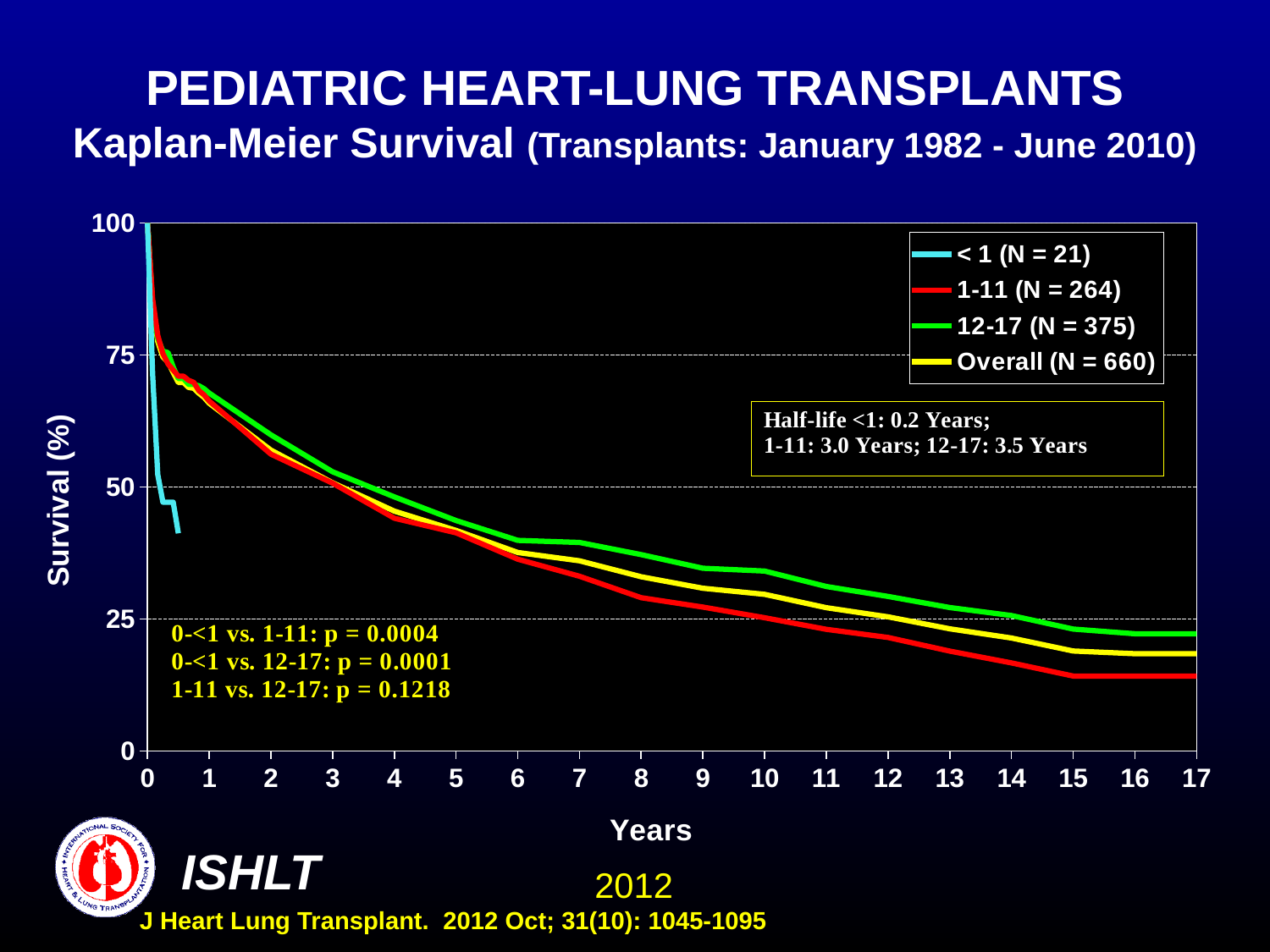
Is the survival for the 1-11 group at 15 years greater or less than 25? less Is the survival for the 12-17 group at 10 years greater or less than 25? greater What is the half-life reported for the 1-11 age group? 3.0 Years How many series does the legend list? 4 Which age group has the shortest half-life? < 1 What kind of chart is shown on the slide? line chart What is the p-value for 0-<1 vs. 12-17? 0.0001 Is the Overall survival at 5 years greater or less than 50? less At 10 years, which group has higher survival, 12-17 or 1-11? 12-17 What is the p-value for 1-11 vs. 12-17? 0.1218 Do the survival curves rise or fall as years increase? fall According to the legend, what is N for the 12-17 age group? 375